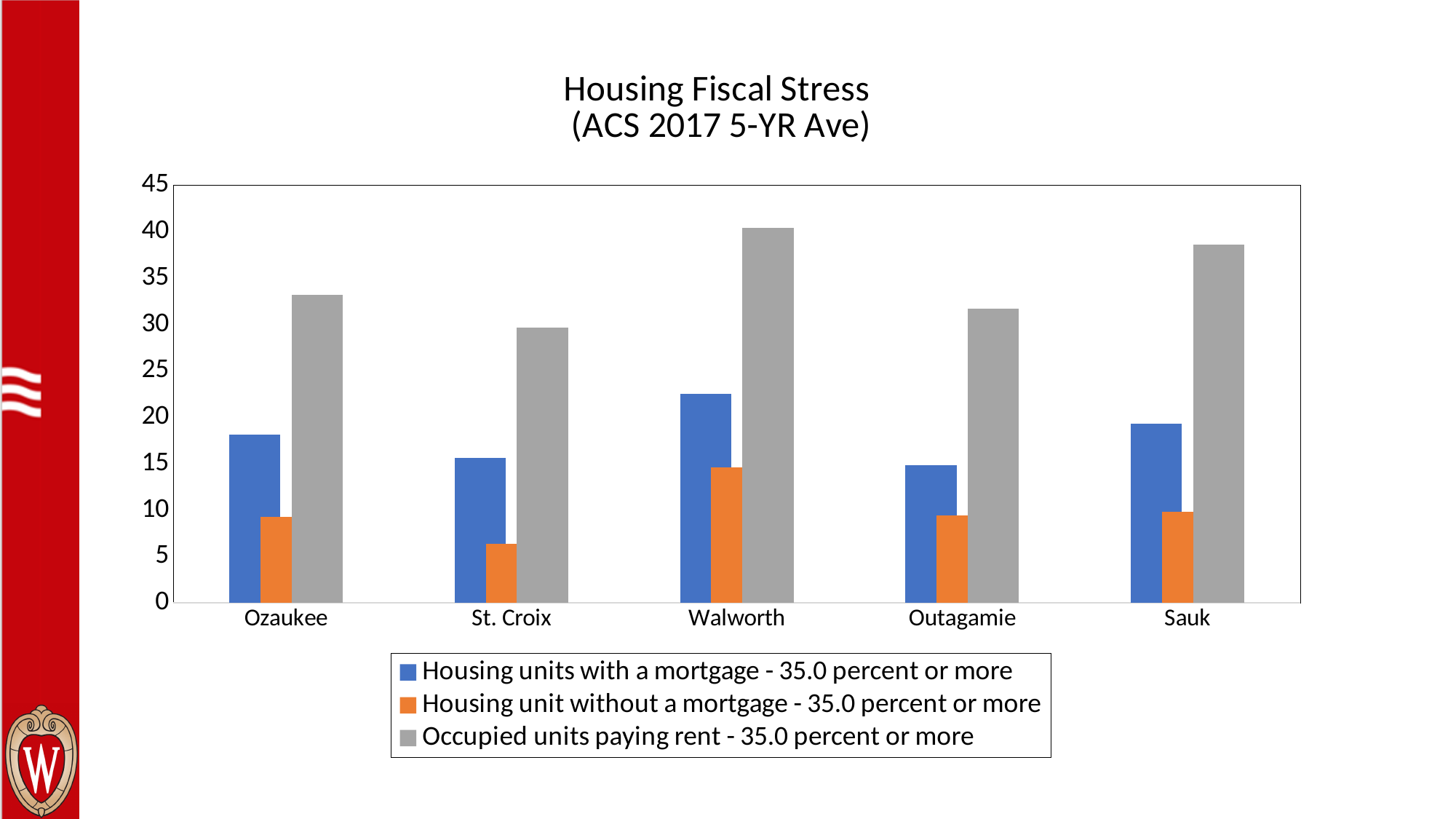
Which county has the lowest value for Housing unit without a mortgage - 35.0 percent or more? St. Croix What kind of chart is shown on the slide? Bar chart How many counties are shown on the x axis? 5 What is the title of the chart? Housing Fiscal Stress (ACS 2017 5-YR Ave) Is the value for Occupied units paying rent - 35.0 percent or more in Sauk greater or less than 35? greater Is the value for Housing unit without a mortgage - 35.0 percent or more in St. Croix greater or less than 10? less Is the value for Housing units with a mortgage - 35.0 percent or more in Ozaukee greater or less than 20? less Which is larger: Housing units with a mortgage - 35.0 percent or more in Walworth or in Sauk? Walworth How many series does the legend list? 3 Which county has the highest value for Occupied units paying rent - 35.0 percent or more? Walworth Which county has the highest value for Housing units with a mortgage - 35.0 percent or more? Walworth